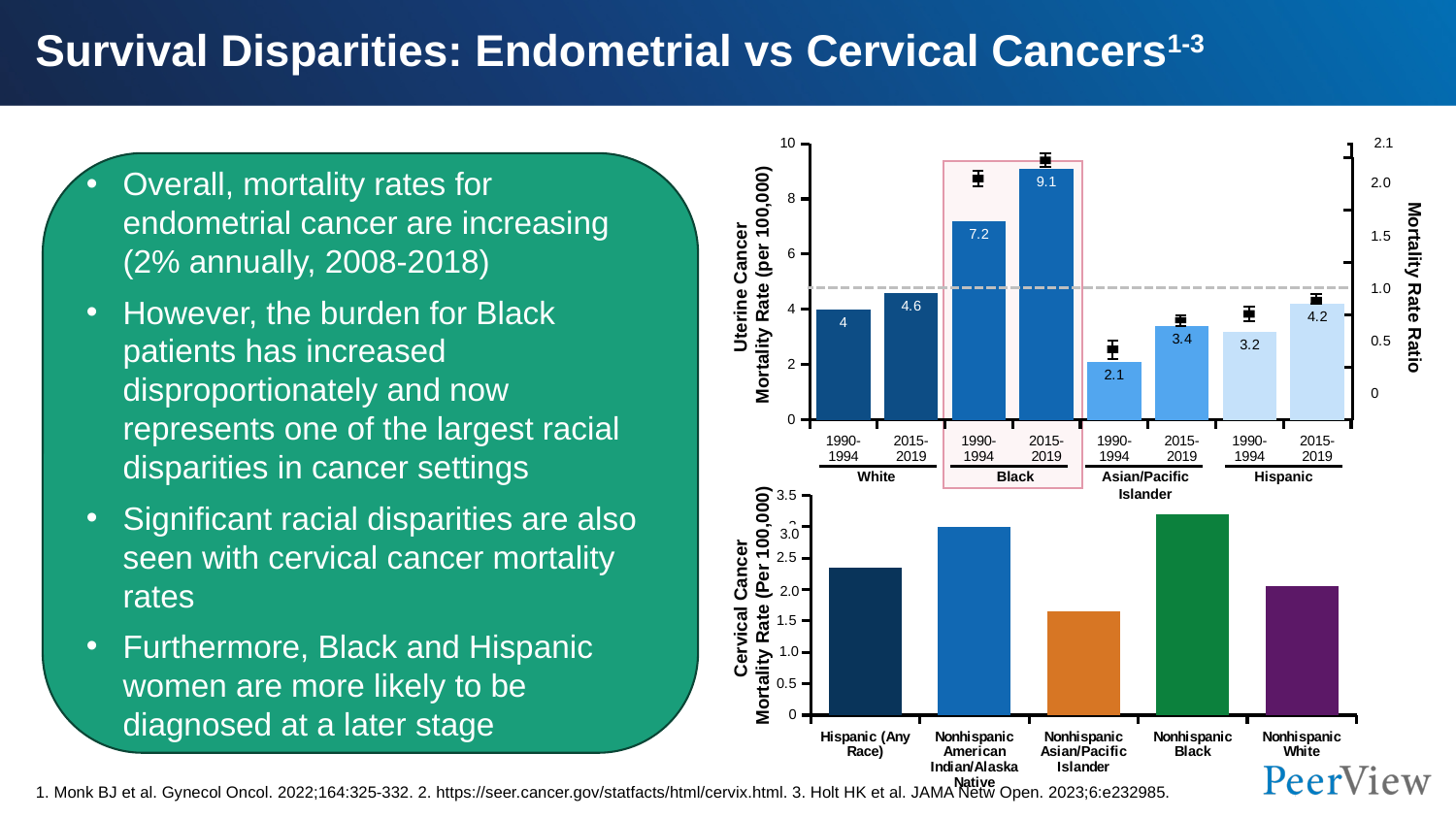
How many bars are plotted in the top chart (Uterine Cancer Mortality Rate)? 8 What kind of chart is the bottom chart (Cervical Cancer Mortality Rate)? bar chart In the top chart (Uterine Cancer Mortality Rate), what is the difference between the Black 2015-2019 value and the Black 1990-1994 value? 1.9 In the top chart (Uterine Cancer Mortality Rate), what is the difference between the White 2015-2019 value and the White 1990-1994 value? 0.6 In the bottom chart (Cervical Cancer Mortality Rate), which group has the lowest value? Nonhispanic Asian/Pacific Islander In the bottom chart (Cervical Cancer Mortality Rate), is the value for Hispanic (Any Race) greater or less than 2.0? greater In the top chart (Uterine Cancer Mortality Rate), which is larger for 2015-2019: the Hispanic value or the Asian/Pacific Islander value? Hispanic In the top chart (Uterine Cancer Mortality Rate), what is the value for White patients in 1990-1994? 4 In the top chart (Uterine Cancer Mortality Rate), which bar has the highest value? Black, 2015-2019 In the top chart (Uterine Cancer Mortality Rate), what is the value for Black patients in 2015-2019? 9.1 In the top chart (Uterine Cancer Mortality Rate), which bar has the lowest value? Asian/Pacific Islander, 1990-1994 In the bottom chart (Cervical Cancer Mortality Rate), which group has the highest value? Nonhispanic Black